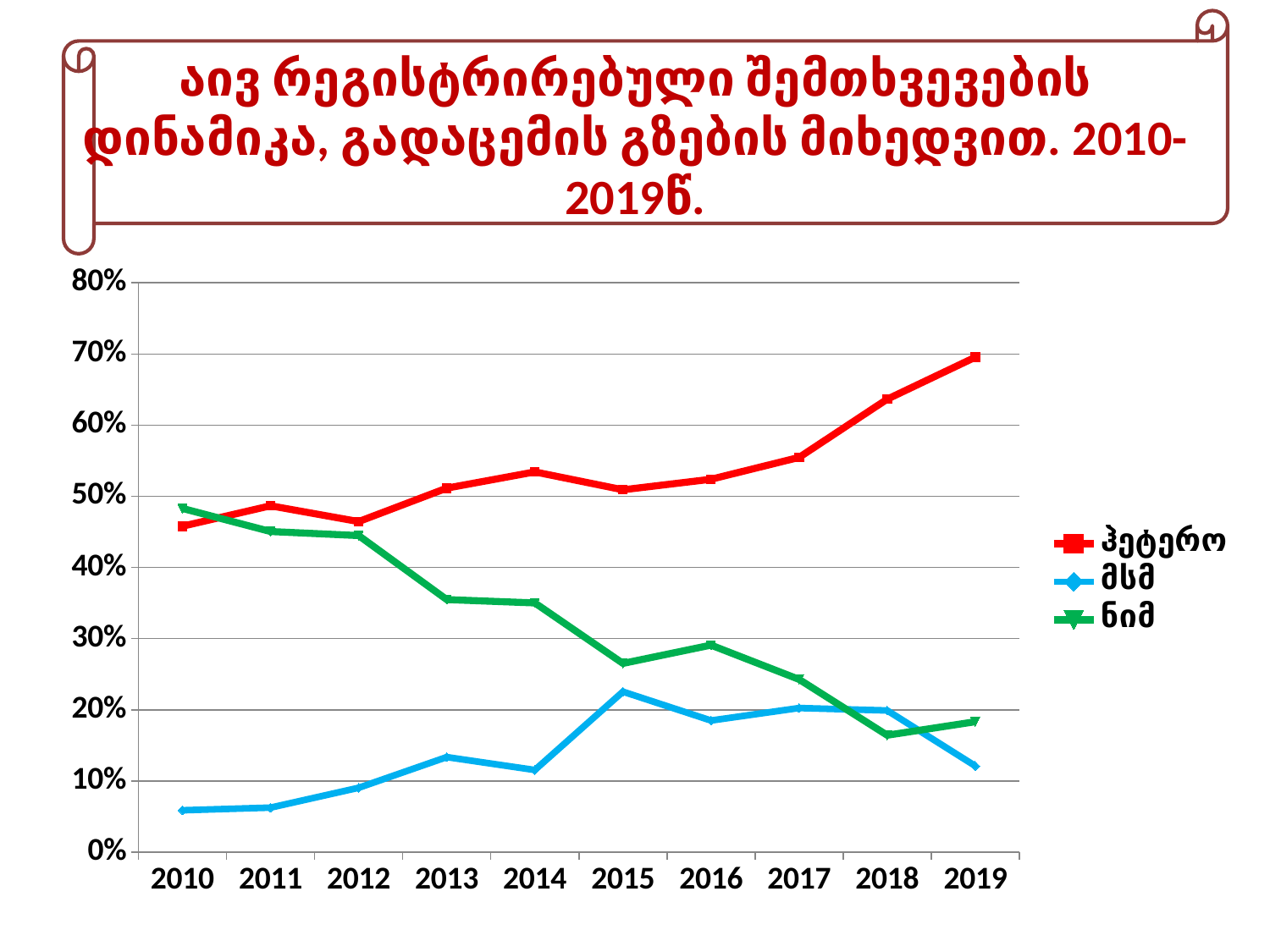
In which year does the ნიმ series reach its lowest value? 2018 In which year does the ჰეტერო series reach its highest value? 2019 How many years are shown on the x axis? 10 How many series does the legend list? 3 Is the value for ჰეტერო in 2019 greater or less than 60%? greater What colour is the ჰეტერო line? red What kind of chart is shown on the slide? line chart Is the value for ნიმ in 2018 greater or less than 20%? less Does the ნიმ series overall rise or fall from 2010 to 2019? fall In which year does the მსმ series reach its highest value? 2015 In 2013, which series has the higher value, ჰეტერო or ნიმ? ჰეტერო Is the value for მსმ in 2010 greater or less than 10%? less